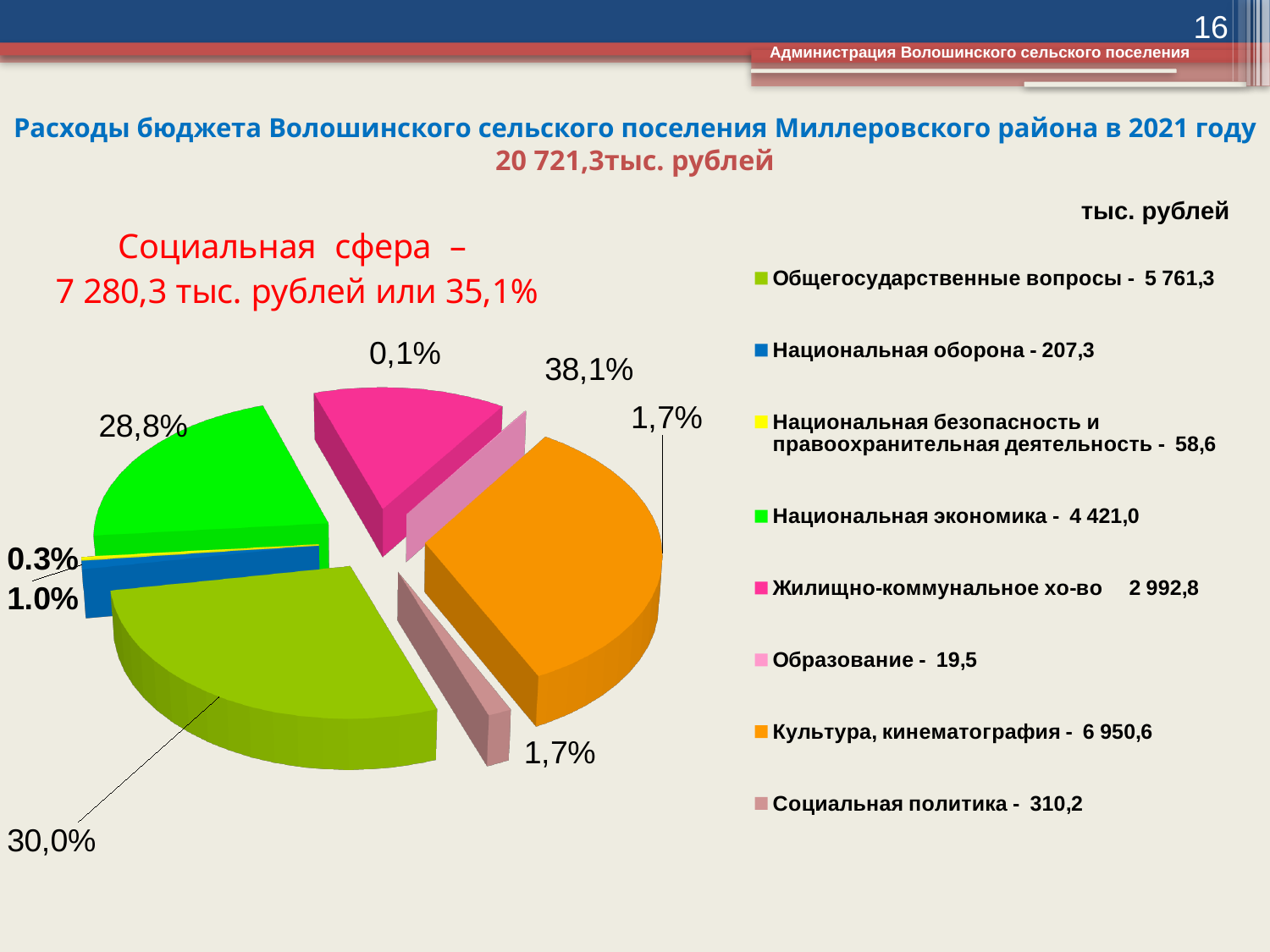
What is the value for Национальная экономика in the legend? 4 421,0 What type of chart is shown on the slide? pie chart What is the difference between Культура, кинематография and Общегосударственные вопросы? 1 189,3 Which category has the smallest value? Образование What is the value for Культура, кинематография in the legend? 6 950,6 What total budget expenditure amount is given in the chart title? 20 721,3 тыс. рублей Which category has the largest value? Культура, кинематография What is the value for Общегосударственные вопросы in the legend? 5 761,3 What percentage label is shown for the orange slice (Культура, кинематография)? 38,1% Which is larger: Социальная политика or Национальная оборона? Социальная политика How many expenditure categories does the legend list? 8 What is the value for Образование in the legend? 19,5